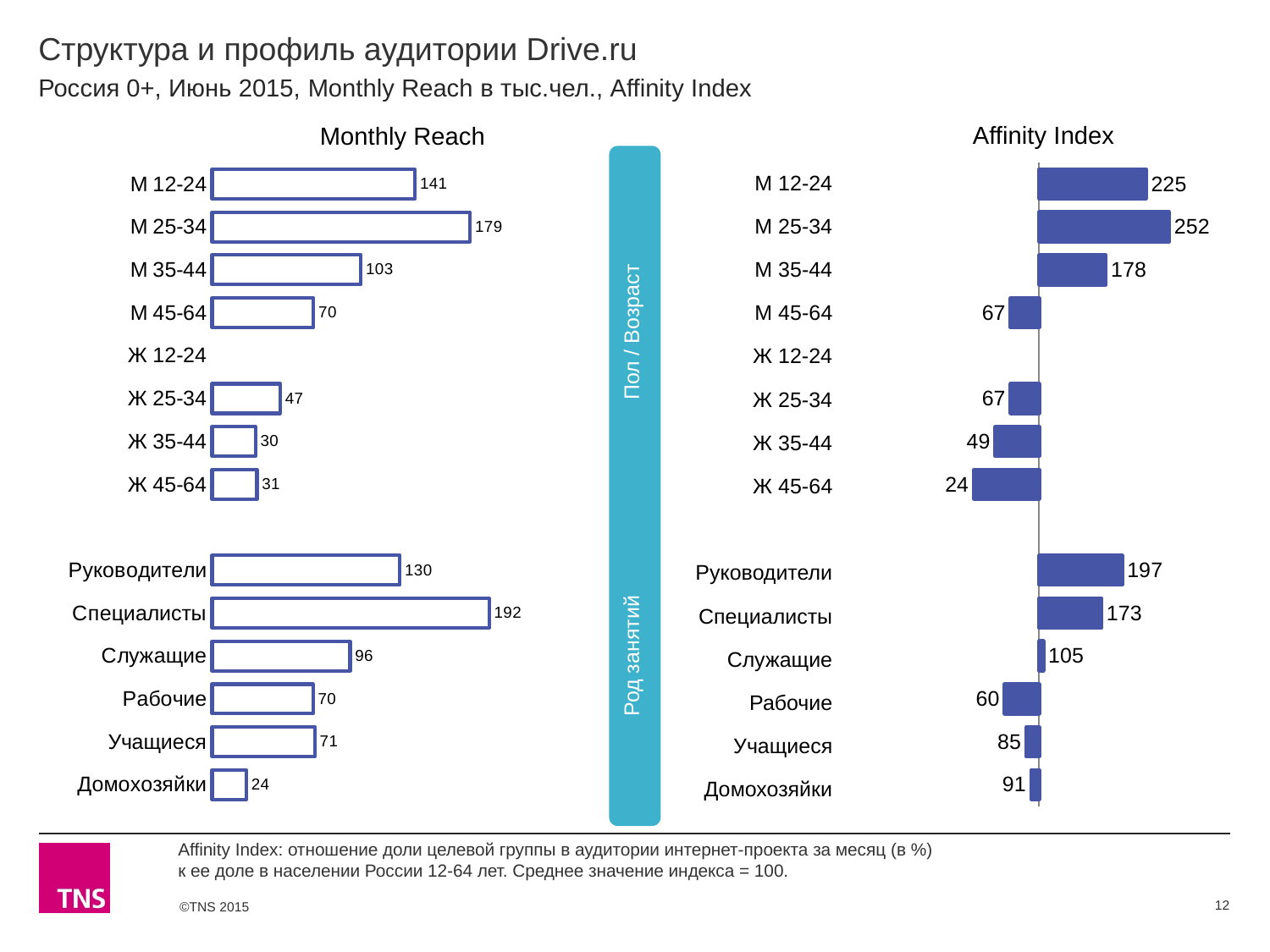
In the Monthly Reach chart, what is the value for Домохозяйки? 24 In the Monthly Reach chart, which is larger: the value for Рабочие or the value for Учащиеся? Учащиеся In the Affinity Index chart, which category has the lowest value? Ж 45-64 In the Monthly Reach chart, which category has the highest value? Специалисты In the Affinity Index chart, what is the value for Служащие? 105 In the Affinity Index chart, what is the difference between the values for Специалисты and Рабочие? 113 What kind of chart is the Monthly Reach chart? Bar chart In the Affinity Index chart, what is the value for Руководители? 197 In the Monthly Reach chart, what is the difference between the values for М 12-24 and М 35-44? 38 In the Monthly Reach chart, what is the value for М 25-34? 179 What is the title of the chart on the right side of the slide? Affinity Index In the Affinity Index chart, which is larger: the value for М 12-24 or the value for М 25-34? М 25-34